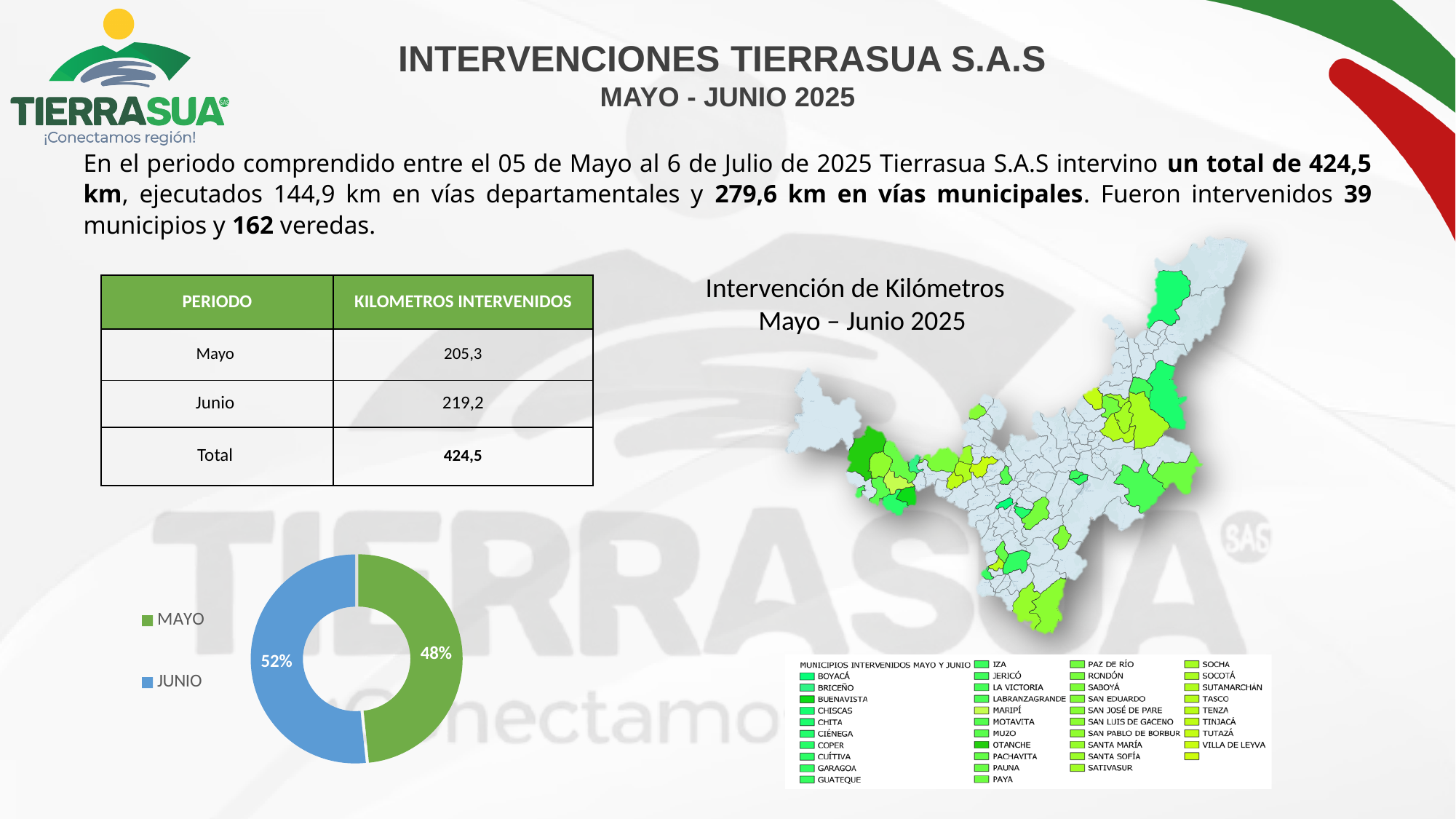
In the pie chart, what colour is the JUNIO slice? Blue In the pie chart, what colour is the MAYO slice? Green In the pie chart, which period has the largest share? JUNIO In the pie chart, is the share for MAYO greater or less than 50%? less What kind of chart is shown at the bottom left of the slide? Pie (doughnut) chart How many entries does the legend of the pie chart list? 2 In the pie chart, which period has the smallest share? MAYO In the pie chart, which is larger, the share for MAYO or the share for JUNIO? JUNIO In the pie chart, what share is labelled for MAYO? 48% In the pie chart, what is the difference in percentage points between the JUNIO share and the MAYO share? 4 percentage points How many slices does the pie chart have? 2 In the pie chart, what share is labelled for JUNIO? 52%